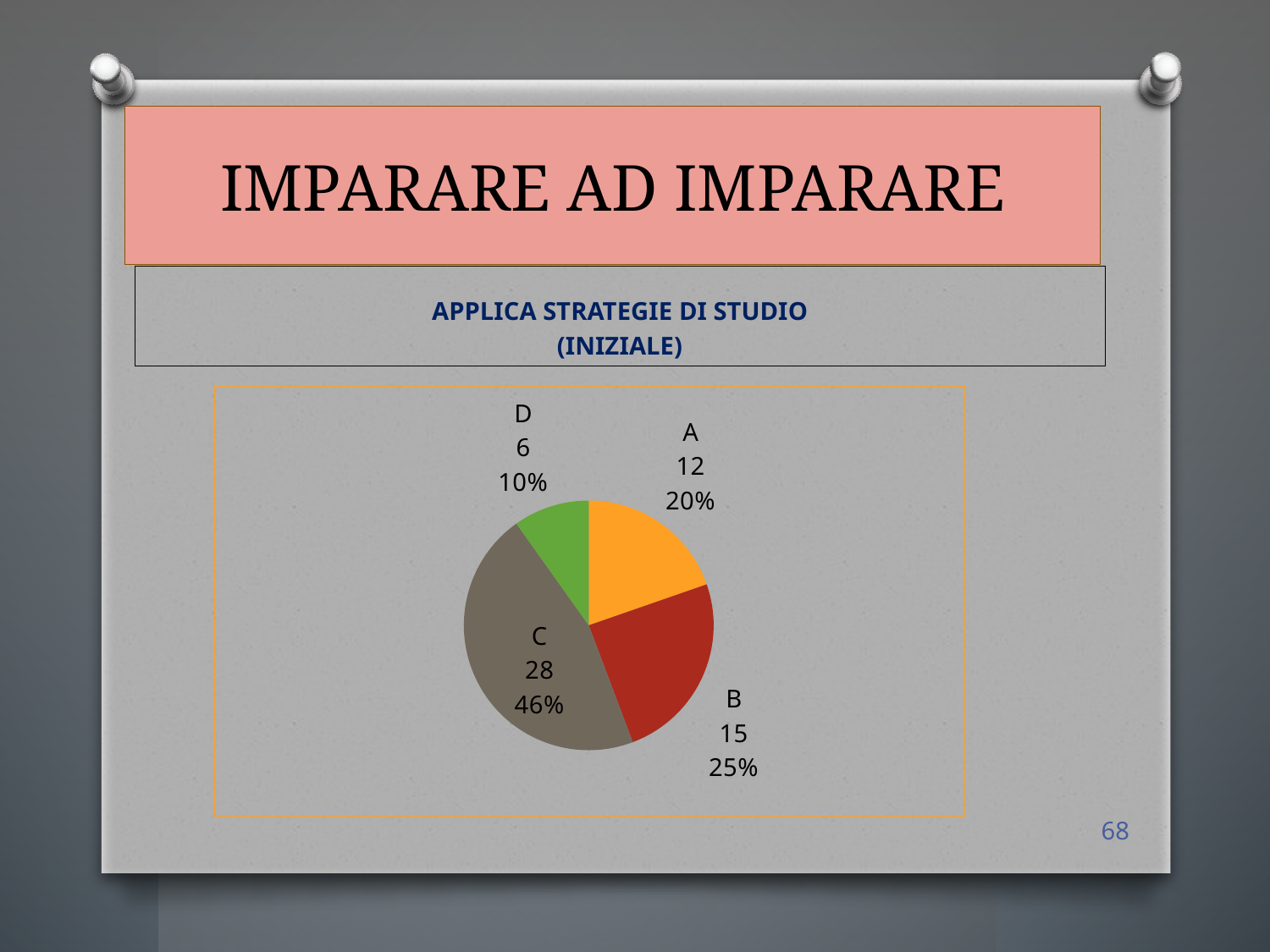
What is the value for category D? 6 What is the value for category A? 12 Which category has the smallest slice? D Which is larger, the value for A or the value for B? B How many slices does the pie chart have? 4 What is the title shown above the chart? APPLICA STRATEGIE DI STUDIO (INIZIALE) What percentage share does category B have? 25% What is the value for category C? 28 Which category has the largest slice? C What is the difference between the values for C and B? 13 What kind of chart is shown on the slide? pie chart What percentage share does category C have? 46%